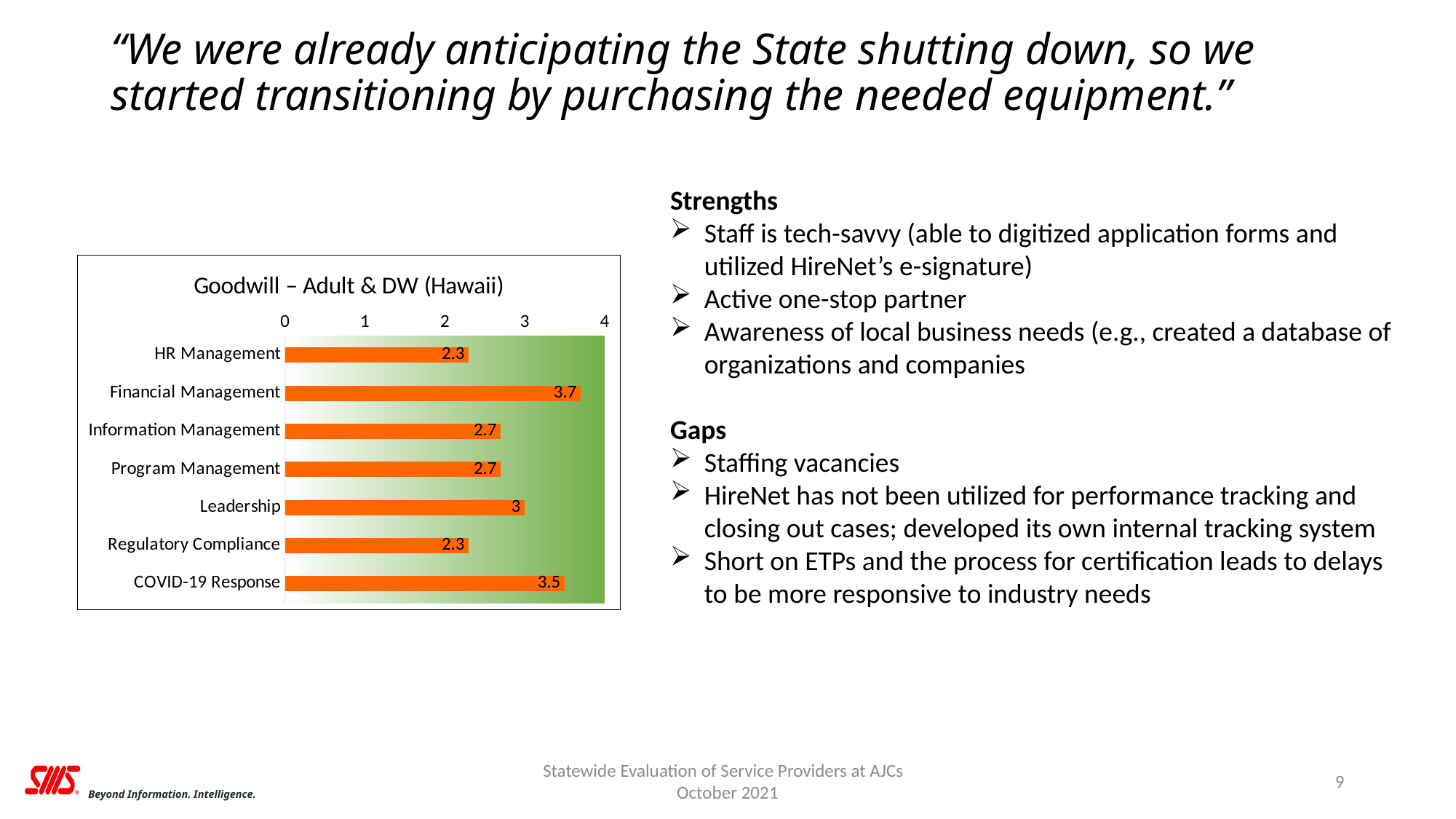
What is the difference between the values for Financial Management and HR Management? 1.4 How many categories are shown in the chart? 7 What is the difference between the values for COVID-19 Response and Regulatory Compliance? 1.2 What is the title of the chart? Goodwill – Adult & DW (Hawaii) Which category has the highest value? Financial Management What is the value for Financial Management? 3.7 Is the value for COVID-19 Response greater or less than 3? greater Which is larger, the value for Leadership or the value for Program Management? Leadership What is the value for Information Management? 2.7 What is the value for Leadership? 3 What kind of chart is shown on the slide? bar chart What is the value for COVID-19 Response? 3.5